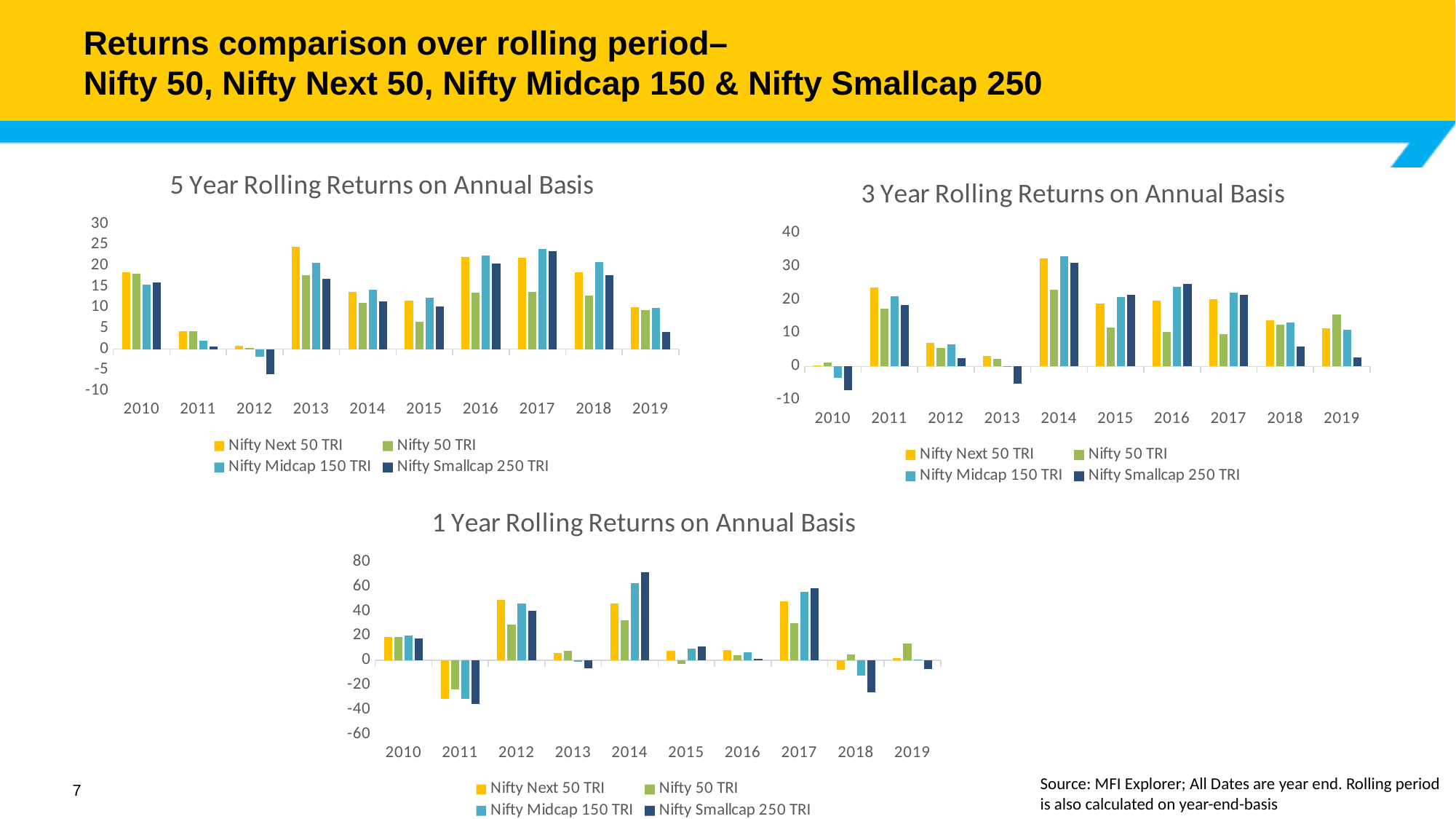
Which series is shown in yellow in the "1 Year Rolling Returns on Annual Basis" chart? Nifty Next 50 TRI In the "3 Year Rolling Returns on Annual Basis" chart, is the value for Nifty Smallcap 250 TRI in 2010 greater or less than 0? less In the "1 Year Rolling Returns on Annual Basis" chart, which is larger in 2012: Nifty Next 50 TRI or Nifty 50 TRI? Nifty Next 50 TRI What kind of chart is the "5 Year Rolling Returns on Annual Basis" chart? bar chart How many years are shown on the x axis of the "1 Year Rolling Returns on Annual Basis" chart? 10 In the "5 Year Rolling Returns on Annual Basis" chart, is the value for Nifty Next 50 TRI in 2013 greater or less than 20? greater In the "1 Year Rolling Returns on Annual Basis" chart, which year has the lowest Nifty Smallcap 250 TRI value? 2011 In the "5 Year Rolling Returns on Annual Basis" chart, is the value for Nifty Smallcap 250 TRI in 2012 greater or less than 0? less How many series does the legend of the "3 Year Rolling Returns on Annual Basis" chart list? 4 In the "5 Year Rolling Returns on Annual Basis" chart, which year has the highest Nifty Next 50 TRI value? 2013 In the "3 Year Rolling Returns on Annual Basis" chart, which is larger in 2018: Nifty Next 50 TRI or Nifty Smallcap 250 TRI? Nifty Next 50 TRI